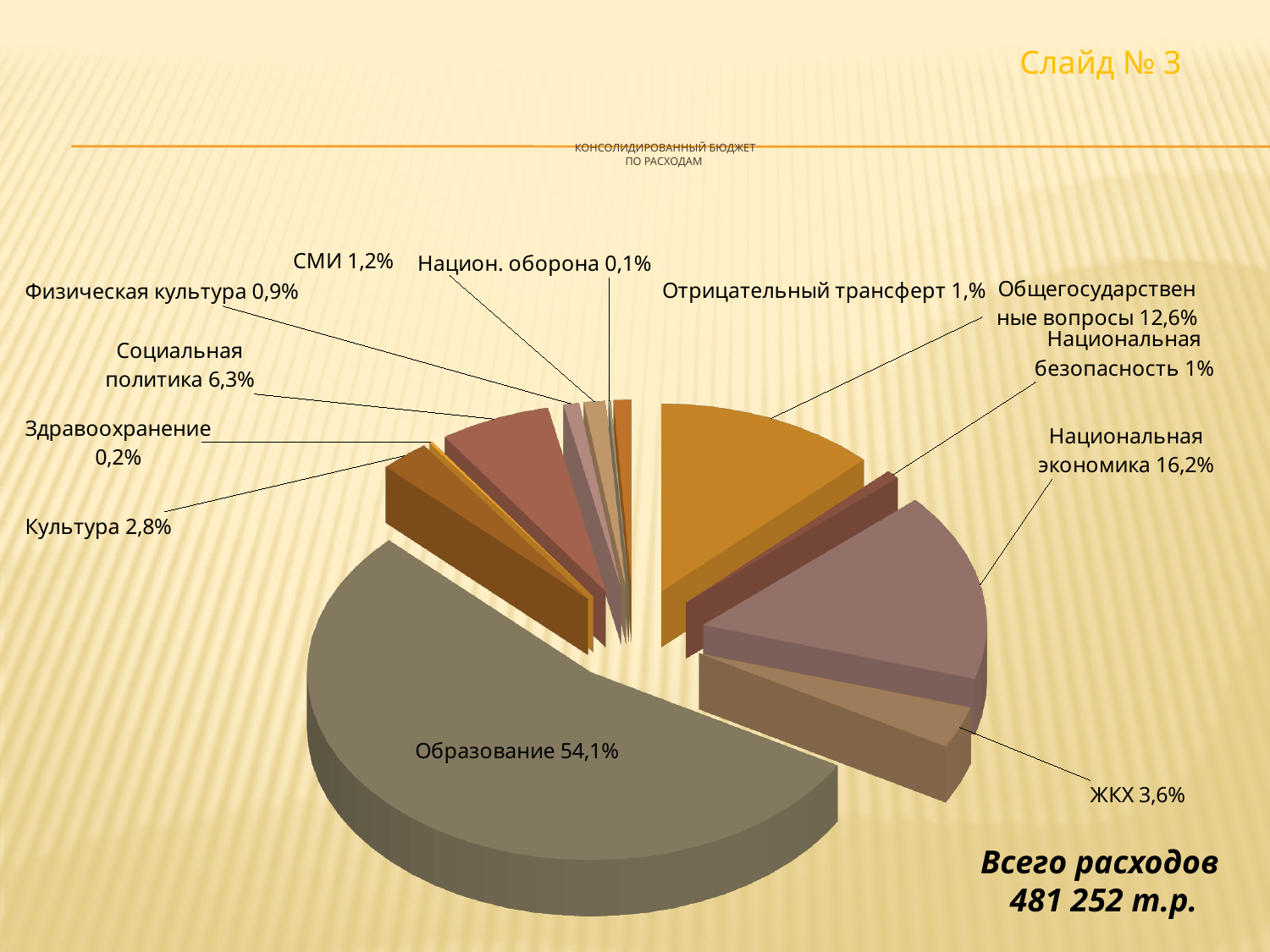
What is the value shown for Общегосударственные вопросы? 12,6% What kind of chart is shown on the slide? pie chart What total expenditure amount is stated on the slide? 481 252 т.р. How many categories are shown in the pie chart? 12 What is the value shown for Социальная политика? 6,3% Which is larger, Национальная экономика or Общегосударственные вопросы? Национальная экономика What is the value shown for ЖКХ? 3,6% What share of the pie does Образование have? 54,1% What is the difference in percentage points between Образование and Национальная экономика? 37,9 What is the value shown for Национальная экономика? 16,2% Which category has the smallest share of the pie? Национ. оборона Which category has the largest share of the pie? Образование